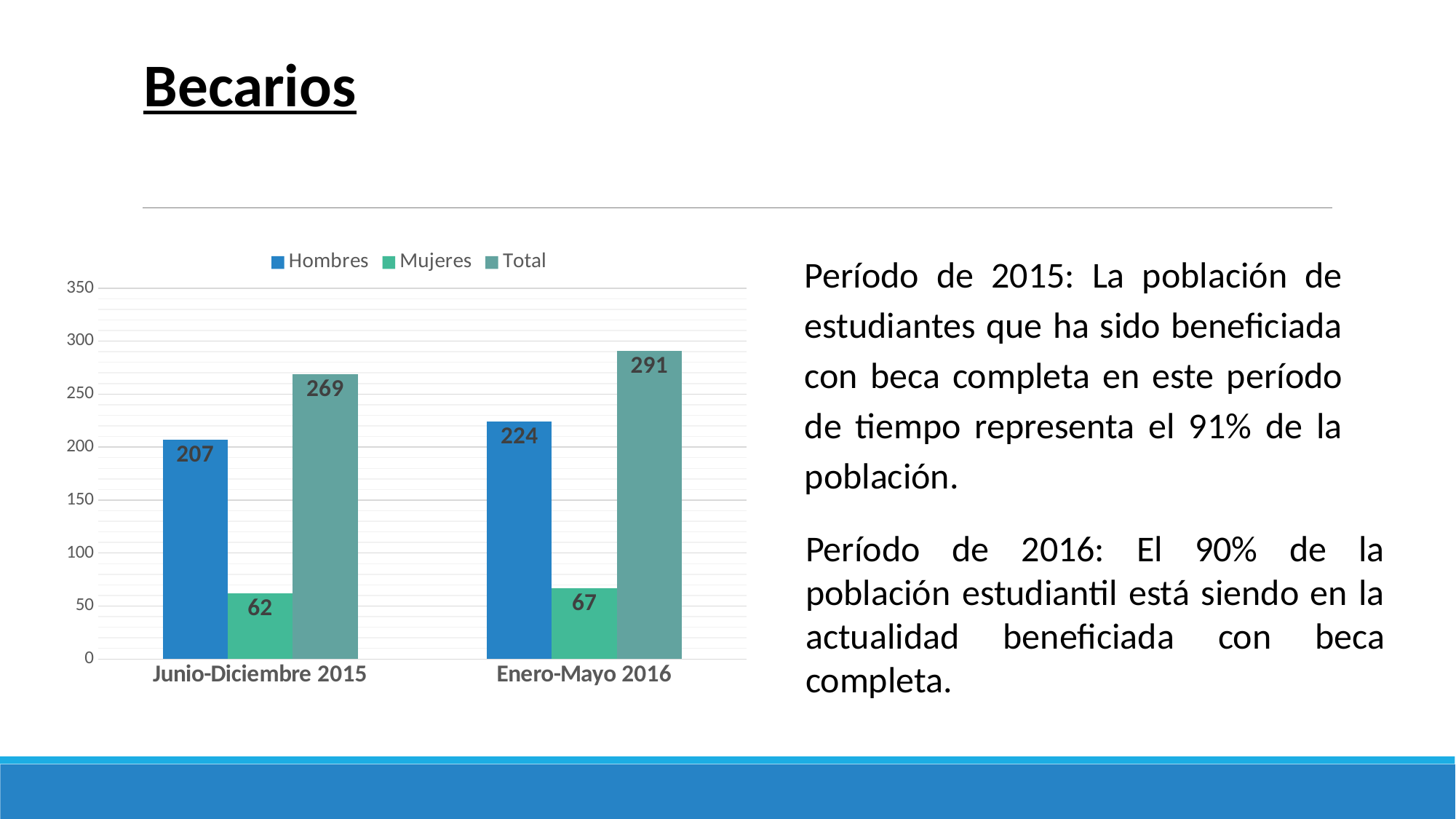
Is the Total value for Enero-Mayo 2016 greater or less than 300? less How many series does the legend list? 3 What kind of chart is shown on the slide? bar chart What is the difference between the Total values for the two periods? 22 Which series has the lowest value in Junio-Diciembre 2015? Mujeres What is the difference between the Hombres values for Enero-Mayo 2016 and Junio-Diciembre 2015? 17 What is the Total value for Enero-Mayo 2016? 291 What is the value for Mujeres in Enero-Mayo 2016? 67 What is the value for Hombres in Junio-Diciembre 2015? 207 How many periods (categories) are shown on the x axis? 2 Is the Mujeres value for Junio-Diciembre 2015 larger or smaller than the Mujeres value for Enero-Mayo 2016? smaller Which period has the higher Total value? Enero-Mayo 2016